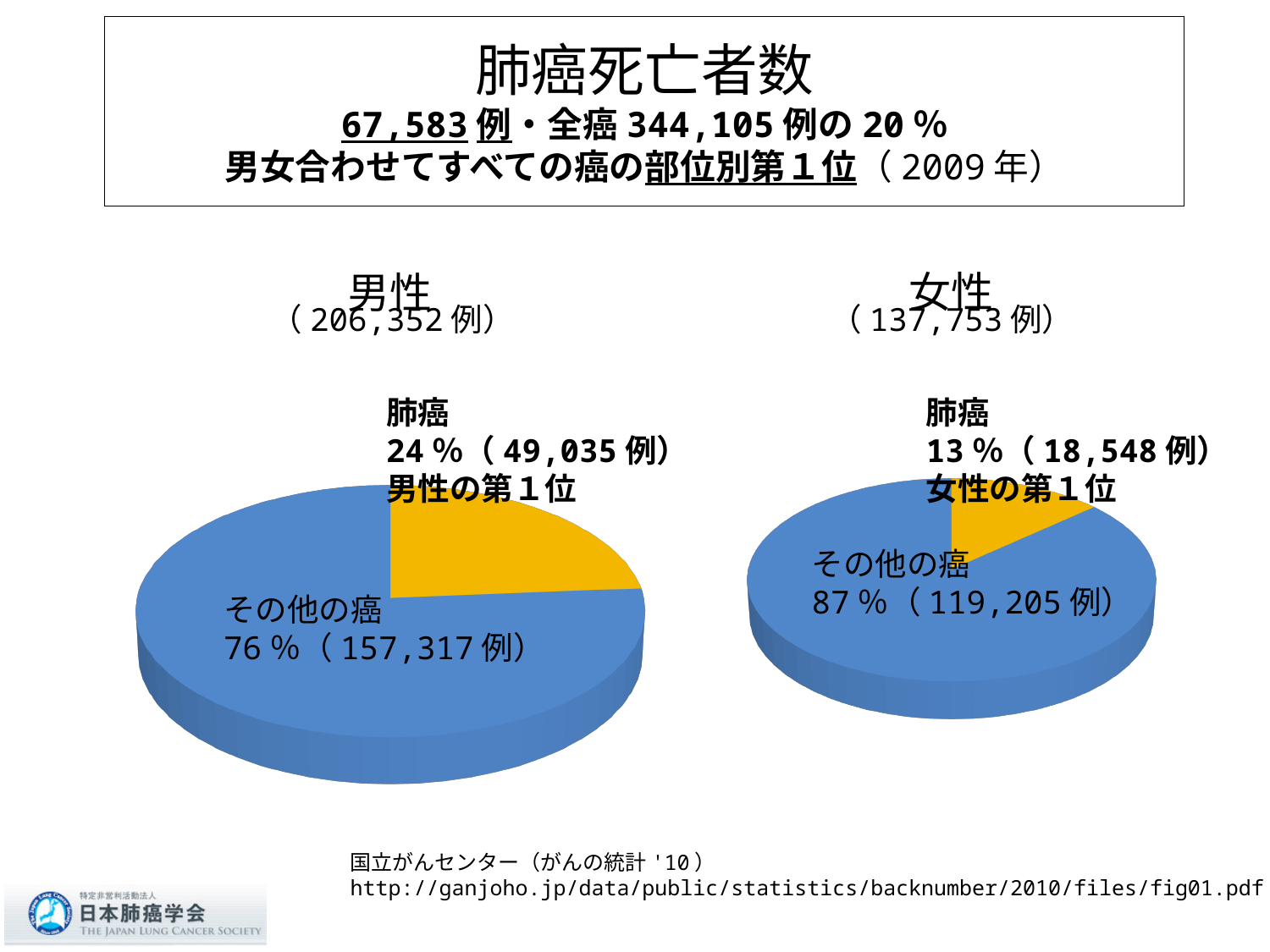
In the 男性 pie chart, what colour is the 肺癌 slice? Yellow In the 女性 pie chart, what share of the pie does その他の癌 take? 87% How many slices does the 男性 pie chart have? 2 In the 男性 pie chart, what share of the pie does 肺癌 take? 24% In the 女性 pie chart, what share of the pie does 肺癌 take? 13% In the 女性 pie chart, how many cases are shown for 肺癌? 18,548例 In the 男性 pie chart, how many cases are shown for その他の癌? 157,317例 In the 男性 pie chart, which slice is the largest? その他の癌 What is the difference in percentage points between the 肺癌 share in the 男性 chart and the 肺癌 share in the 女性 chart? 11 Which chart shows a larger percentage for 肺癌, the 男性 chart or the 女性 chart? 男性 What type of chart is used for the 女性 data? Pie chart In the 女性 pie chart, which slice is the smallest? 肺癌